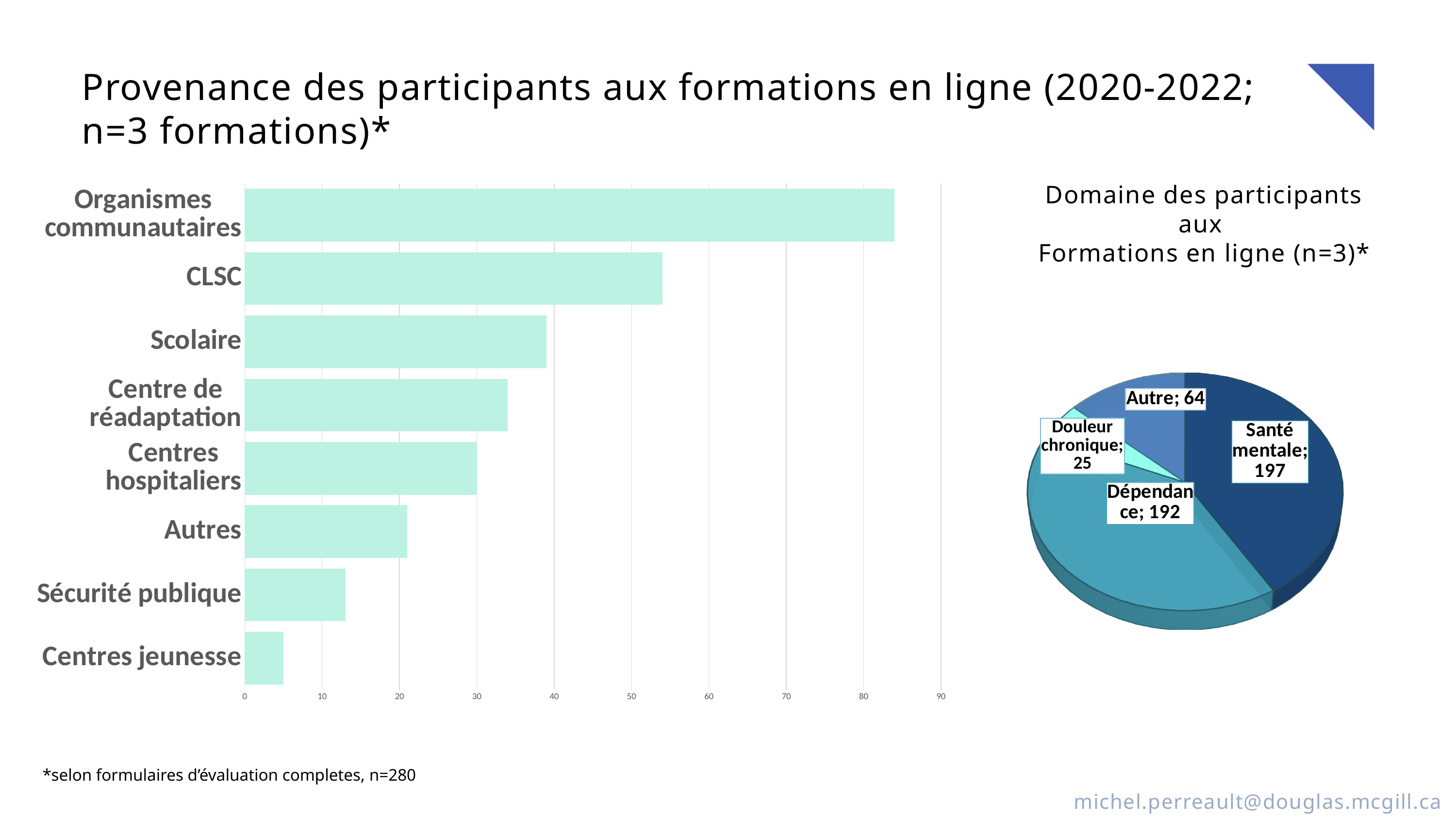
What kind of chart is the left chart, 'Provenance des participants aux formations en ligne'? bar chart In the left bar chart, is the value for CLSC greater or less than 50? greater In the left bar chart, is the value for Organismes communautaires greater or less than 80? greater In the left bar chart, how many categories are shown? 8 In the pie chart 'Domaine des participants', what is the value for Douleur chronique? 25 In the left bar chart, which category has the highest value? Organismes communautaires What kind of chart is the right chart, 'Domaine des participants aux Formations en ligne (n=3)'? pie chart In the left bar chart, which category has the lowest value? Centres jeunesse In the pie chart 'Domaine des participants', what is the value for Santé mentale? 197 In the left bar chart, which is larger, the value for Scolaire or the value for Autres? Scolaire In the pie chart 'Domaine des participants', what is the difference between the values for Santé mentale and Dépendance? 5 In the left bar chart, is the value for Centres jeunesse greater or less than 10? less